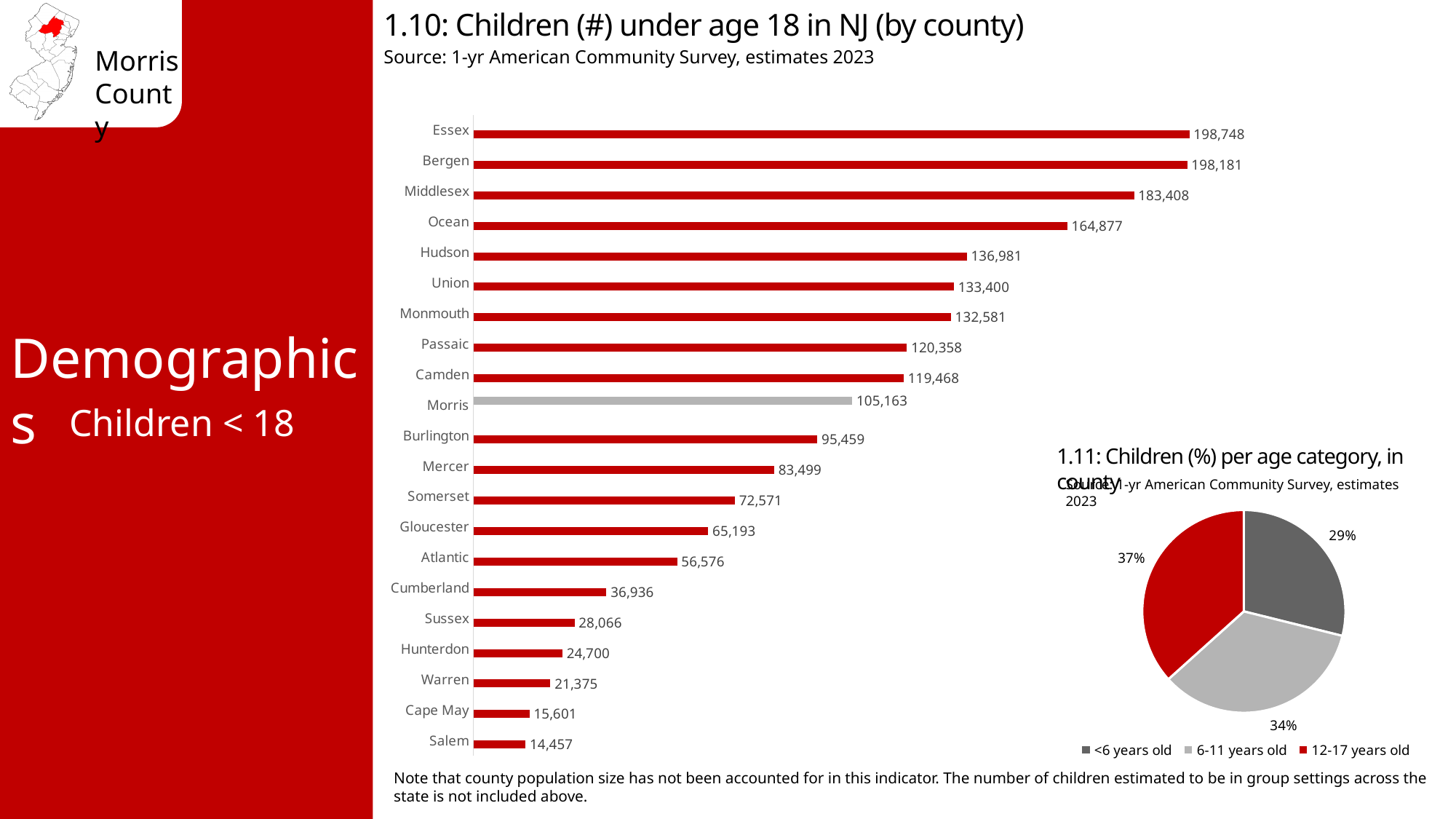
How many categories does the legend of chart 1.11 list? 3 In chart 1.10, which county has the highest number of children under age 18? Essex What kind of chart is chart 1.10? Bar chart In chart 1.10, which county has the lowest number of children under age 18? Salem In chart 1.11, what percentage of children are 6-11 years old? 34% In chart 1.10, what is the value shown for Ocean County? 164,877 In chart 1.10, what is the difference between the values for Essex and Bergen? 567 In chart 1.10, how many counties are shown? 21 In chart 1.11, which age category has the largest share? 12-17 years old In chart 1.10, what is the difference between the values for Morris and Salem? 90,706 In chart 1.10, which has more children under 18, Passaic or Camden? Passaic In chart 1.10, how many children under age 18 are in Morris County? 105,163